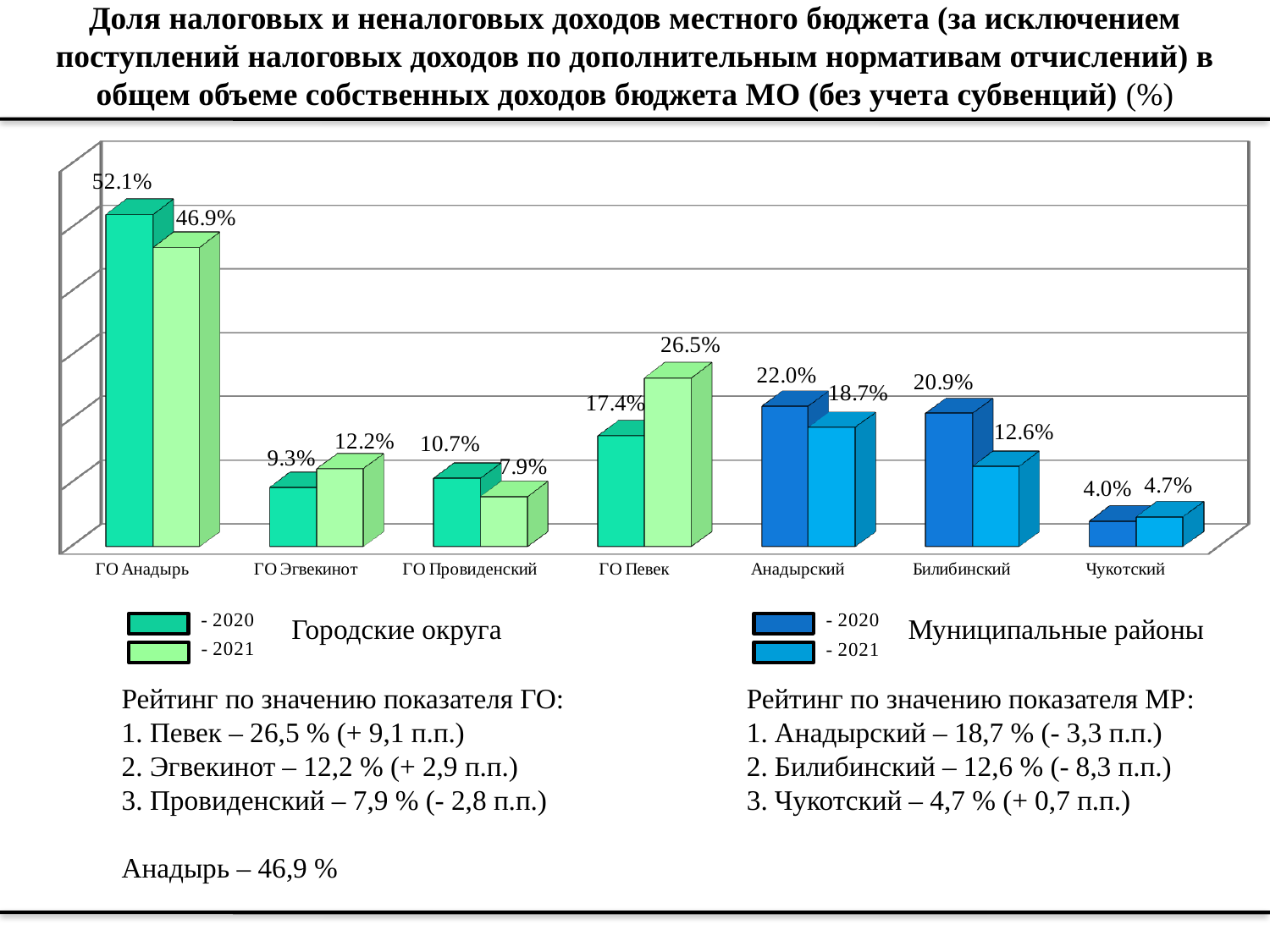
What is the difference between the 2020 and 2021 values for ГО Анадырь? 5.2% Which is larger for Анадырский: the 2020 value or the 2021 value? 2020 What is the difference between the 2021 and 2020 values for ГО Певек? 9.1% What is the 2021 value for Билибинский? 12.6% What kind of chart is shown on the slide? bar chart How many categories are shown on the x axis? 7 Which two years does the legend list? 2020 and 2021 What is the 2020 value for ГО Анадырь? 52.1% What is the 2020 value for Чукотский? 4.0% What is the 2021 value for ГО Певек? 26.5% Which category has the highest 2021 value? ГО Анадырь Which category has the lowest 2020 value? Чукотский